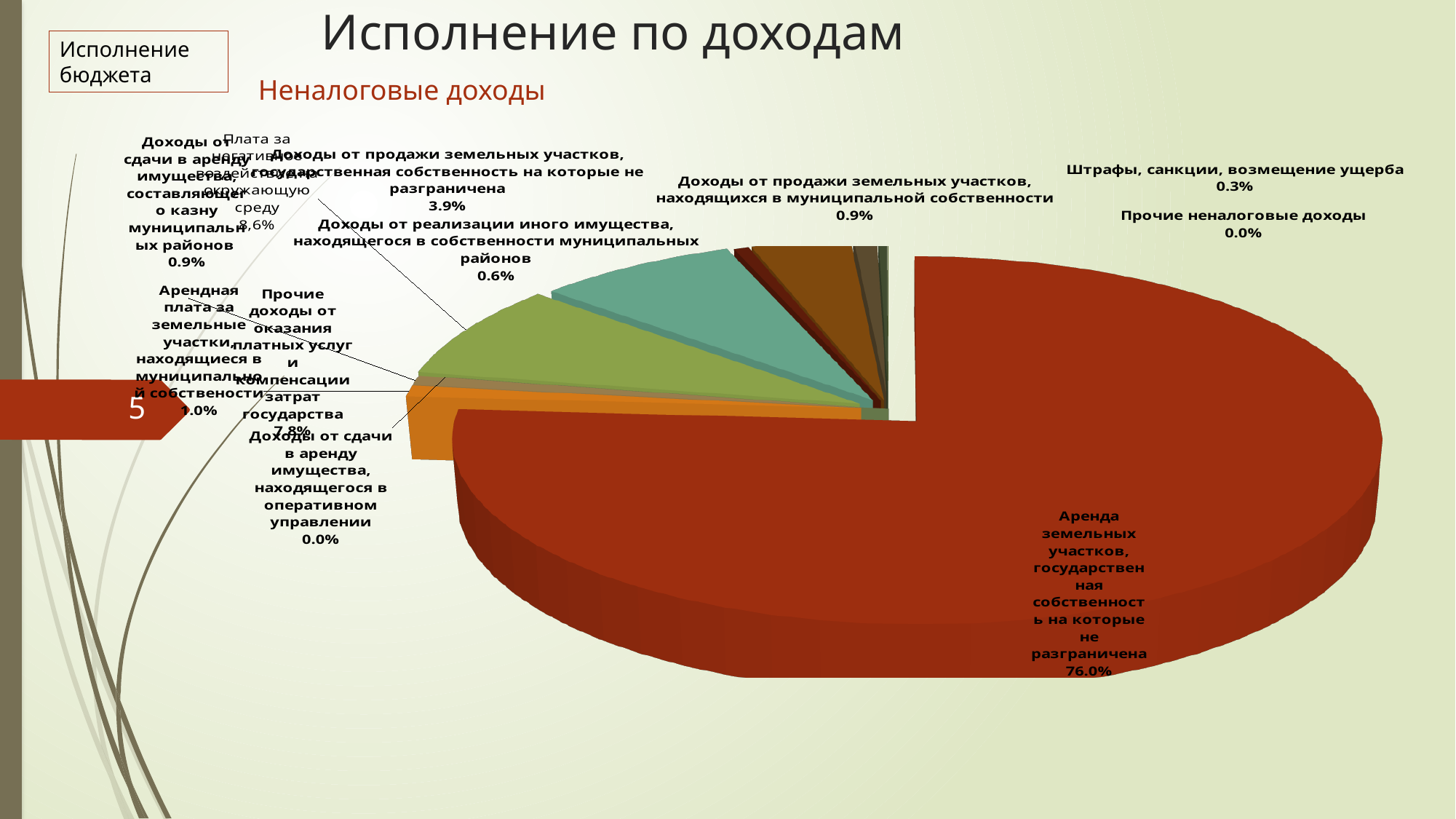
What share does "Прочие доходы от оказания платных услуг и компенсации затрат государства" have? 7.8% What share does "Доходы от продажи земельных участков, государственная собственность на которые не разграничена" have? 3.9% Which is larger: the share of "Прочие доходы от оказания платных услуг и компенсации затрат государства" or the share of "Доходы от продажи земельных участков, государственная собственность на которые не разграничена"? Прочие доходы от оказания платных услуг и компенсации затрат государства What share does "Прочие неналоговые доходы" have? 0.0% By how many percentage points does the share of "Аренда земельных участков, государственная собственность на которые не разграничена" exceed the share of "Прочие доходы от оказания платных услуг и компенсации затрат государства"? 68.2 What share does "Арендная плата за земельные участки, находящиеся в муниципальной собственности" have? 1.0% What share does "Доходы от реализации иного имущества, находящегося в собственности муниципальных районов" have? 0.6% What share does "Штрафы, санкции, возмещение ущерба" have? 0.3% What kind of chart is shown on the slide? pie chart What is the title of the chart? Неналоговые доходы Which category has the largest share of the pie? Аренда земельных участков, государственная собственность на которые не разграничена What share does "Аренда земельных участков, государственная собственность на которые не разграничена" have? 76.0%